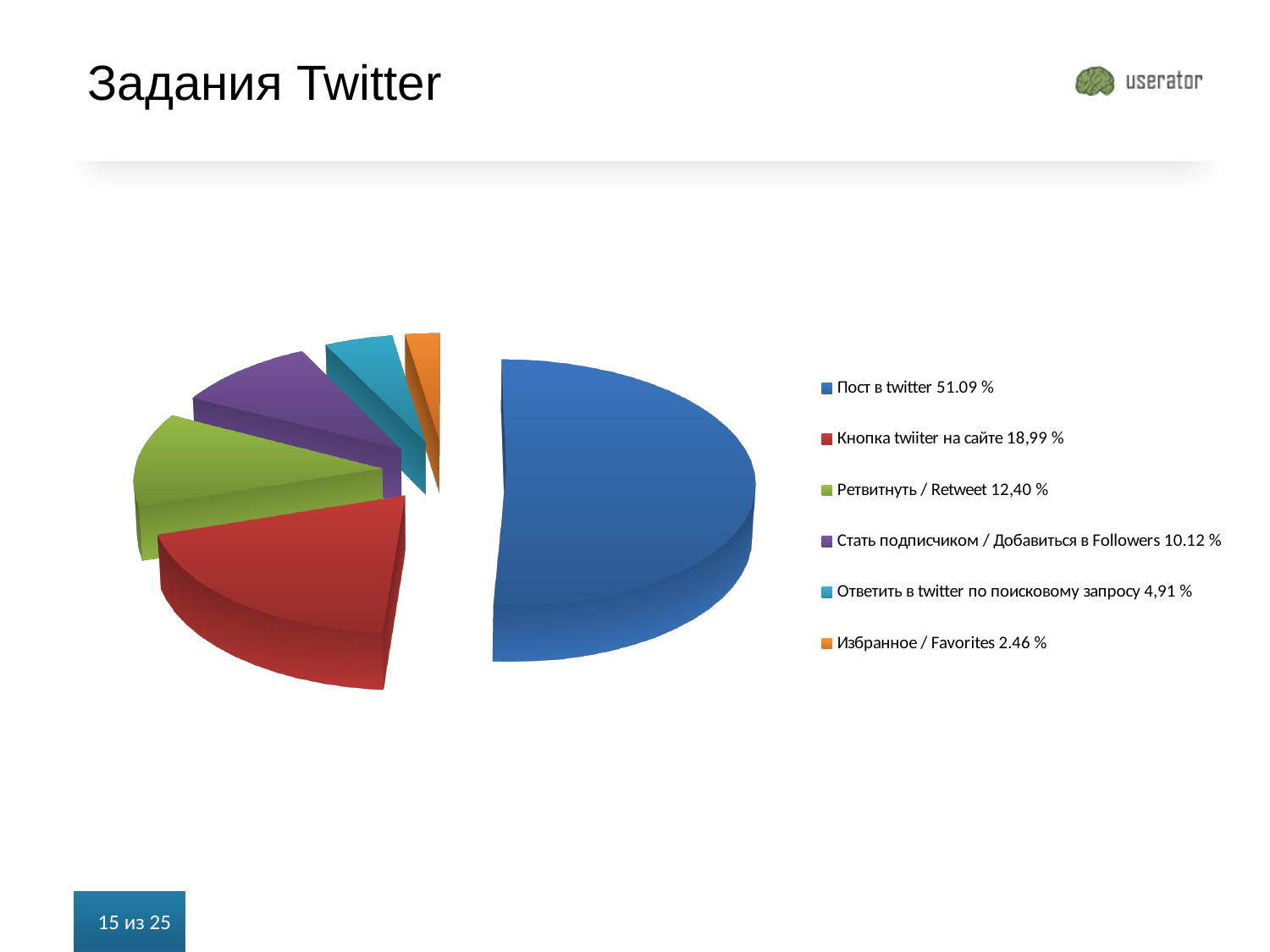
What share does "Кнопка twiiter на сайте" have in the pie chart? 18,99 % What is the difference between the shares of "Ретвитнуть / Retweet" and "Ответить в twitter по поисковому запросу"? 7,49 % What is the difference between the shares of "Стать подписчиком / Добавиться в Followers" and "Избранное / Favorites"? 7.66 % What share does "Пост в twitter" have in the pie chart? 51.09 % Which is larger: the share of "Кнопка twiiter на сайте" or the share of "Ретвитнуть / Retweet"? Кнопка twiiter на сайте How many categories does the pie chart show? 6 Which category has the largest slice of the pie chart? Пост в twitter What colour is the slice for "Стать подписчиком / Добавиться в Followers"? Purple What share does "Ретвитнуть / Retweet" have in the pie chart? 12,40 % Which category has the smallest slice of the pie chart? Избранное / Favorites What type of chart is shown on the slide? Pie chart What share does "Избранное / Favorites" have in the pie chart? 2.46 %